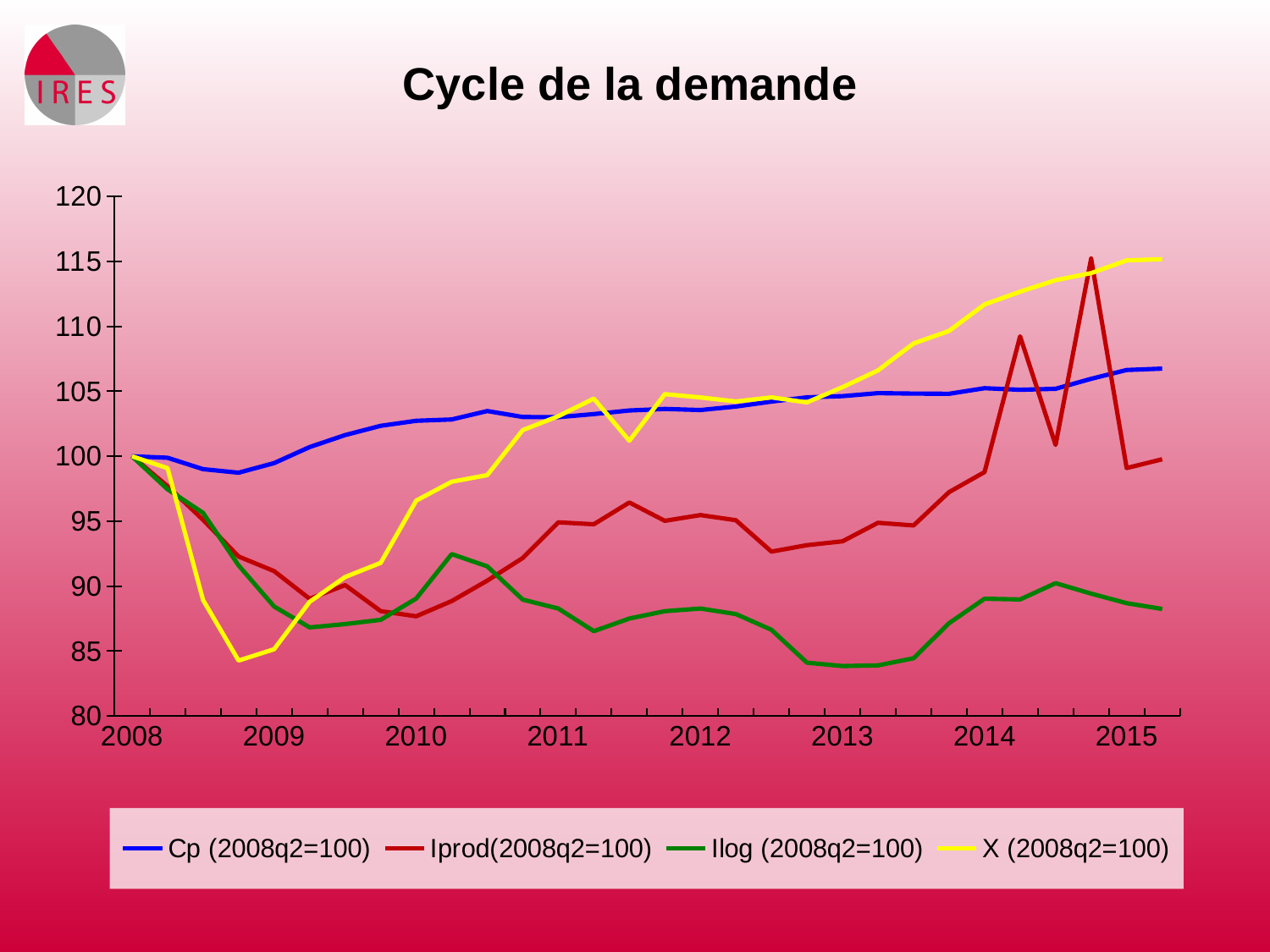
Is the value of Ilog (2008q2=100) at 2013 greater or less than 90? less Is the value of X (2008q2=100) at 2009 greater or less than 90? less How many series does the legend list? 4 Is the value of X (2008q2=100) at 2015 greater or less than 110? greater Does the X (2008q2=100) series rise or fall between 2013 and 2015? rise At 2009, which is larger: Cp (2008q2=100) or X (2008q2=100)? Cp (2008q2=100) Which series has the lowest value at 2015? Ilog (2008q2=100) What kind of chart is shown on the slide? line chart What is the title of the chart? Cycle de la demande Which colour is used for the X (2008q2=100) series? yellow Which series has the highest value at 2015? X (2008q2=100)